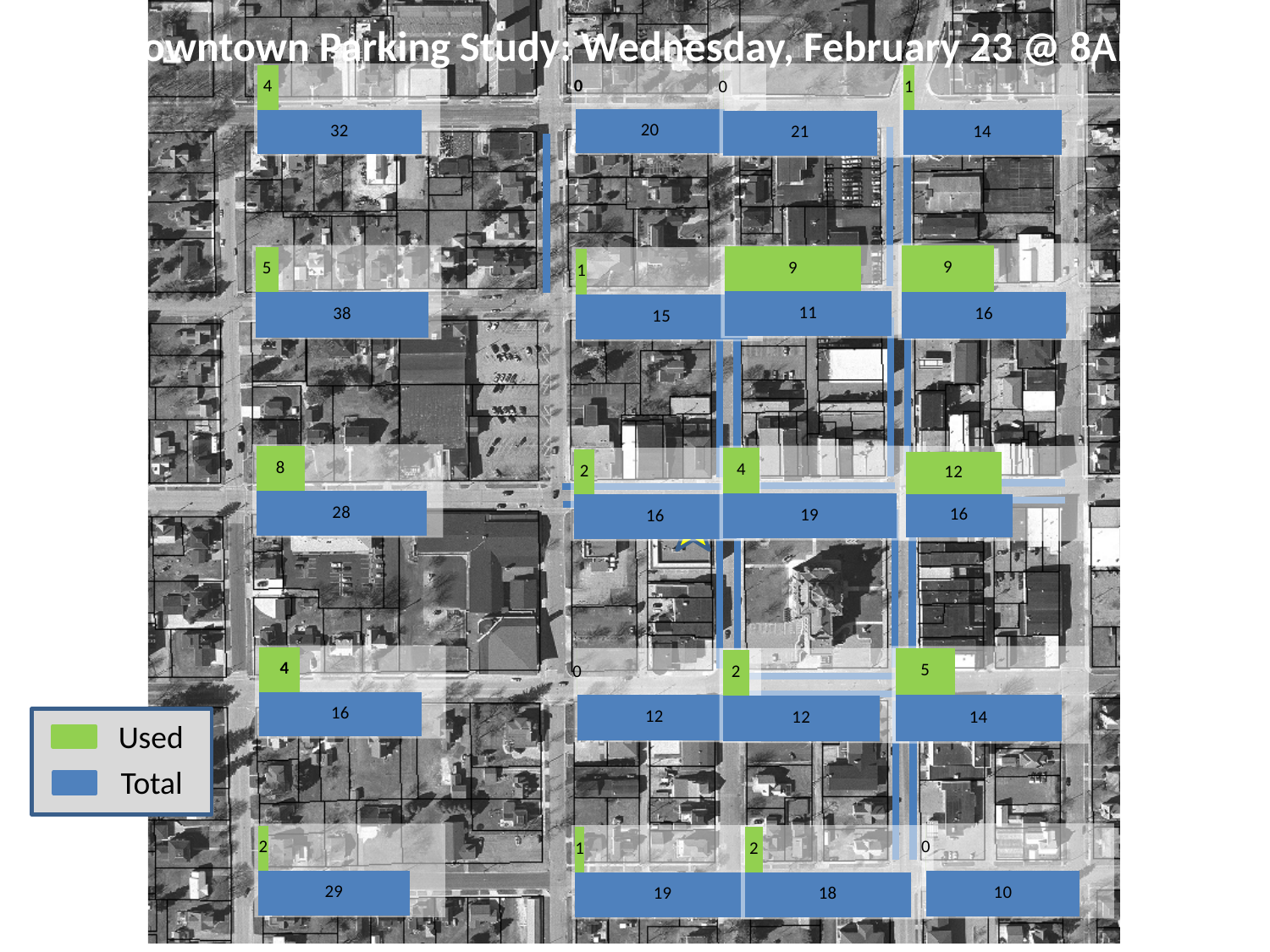
For the top-left block, what is the difference between the Total (32) and Used (4) values? 28 What are the two entries in the legend? Used and Total What is the Used value for the block in the top-left corner of the map? 4 What colour represents the Used series? Green What is the highest Total value shown on the map? 38 What is the Total value for the block in the bottom-right corner of the map? 10 What is the highest Used value shown on the map? 12 Which is larger, the Total of the top-left block or the Total of the bottom-left block? The top-left block (32) For the block with Used 12 and Total 16, how many spaces are unused? 4 What is the Used value for the block whose Total is 38? 5 What is the Total value for the block in the top-left corner of the map? 32 How many series does the legend list? 2